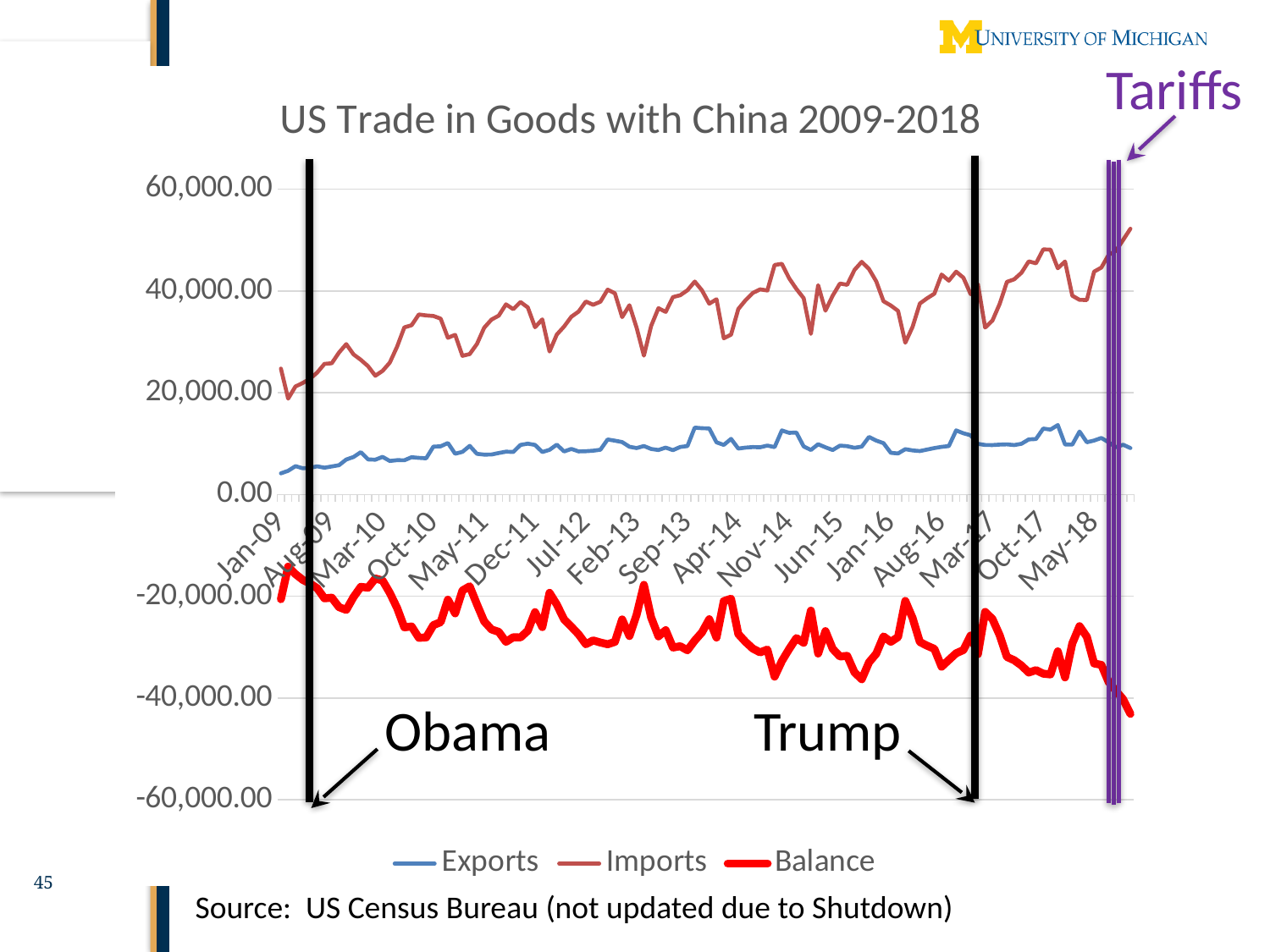
How many date labels are shown on the x axis? 17 How many series does the legend list? 3 What kind of chart is shown on the slide? Line chart Which series has the highest values throughout the chart? Imports Is the value for Balance at May-18 greater or less than -20,000.00? less Which series has the lowest values throughout the chart? Balance What is the title of the chart? US Trade in Goods with China 2009-2018 Do the Imports values generally rise or fall from Jan-09 to the end of the chart? rise Is the value for Exports at Jan-09 greater or less than 20,000.00? less Which series is drawn in red in the legend? Balance Is the value for Imports at Oct-17 greater or less than 40,000.00? greater Which is larger at Jun-15, Imports or Exports? Imports